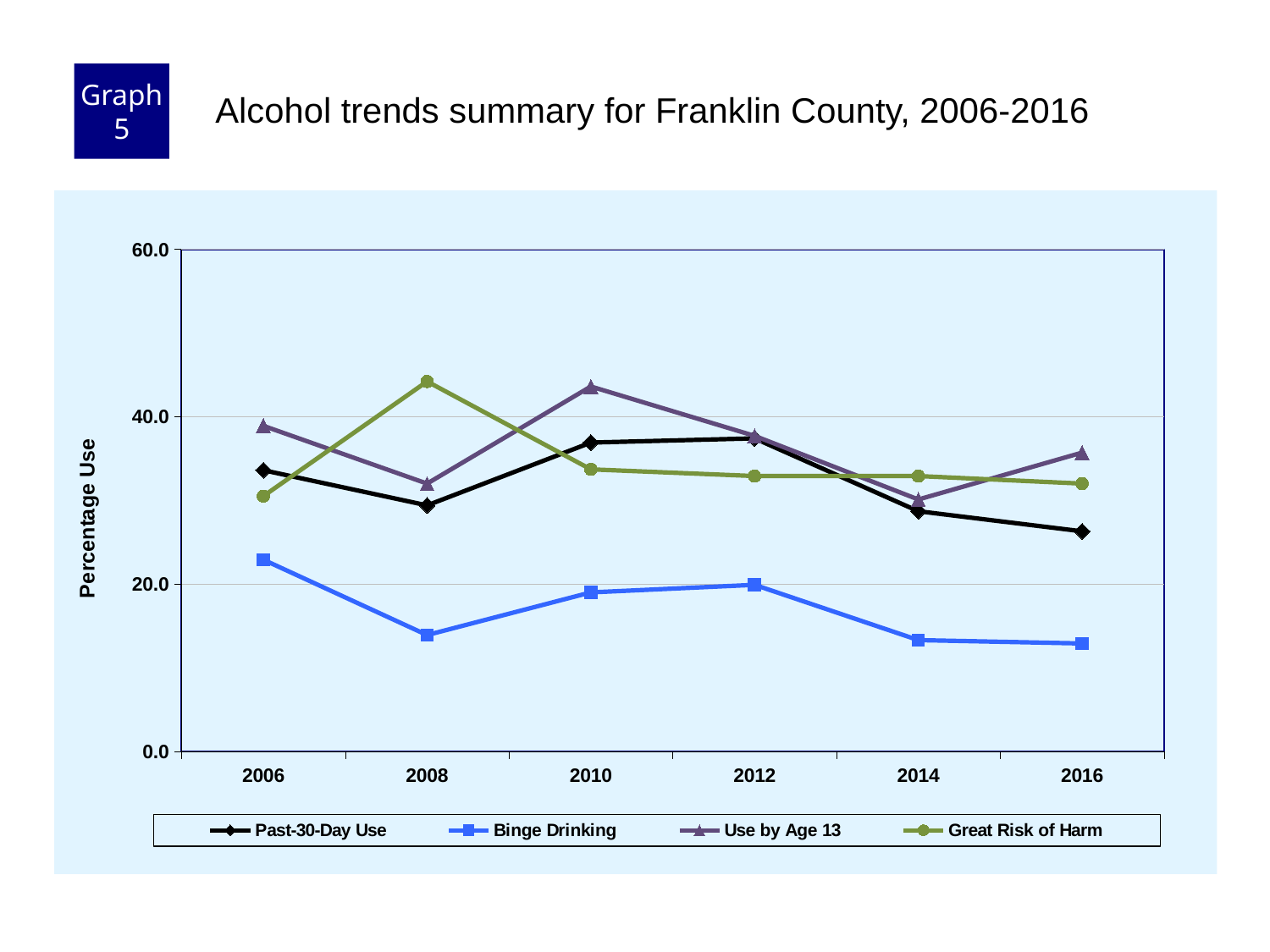
Is the value for Great Risk of Harm in 2008 greater or less than 40.0? greater Does the Binge Drinking line rise or fall from 2012 to 2016? Fall Is the value for Binge Drinking in 2006 greater or less than 20.0? greater How many series does the legend list? 4 Which series has the lowest value in every year shown? Binge Drinking Which is larger for Past-30-Day Use: the value in 2006 or the value in 2016? 2006 Is the value for Binge Drinking in 2008 greater or less than 20.0? less Which series has the highest value in 2008? Great Risk of Harm How many years are plotted along the x axis? 6 What is the label on the y axis? Percentage Use What kind of chart is shown on the slide? Line chart